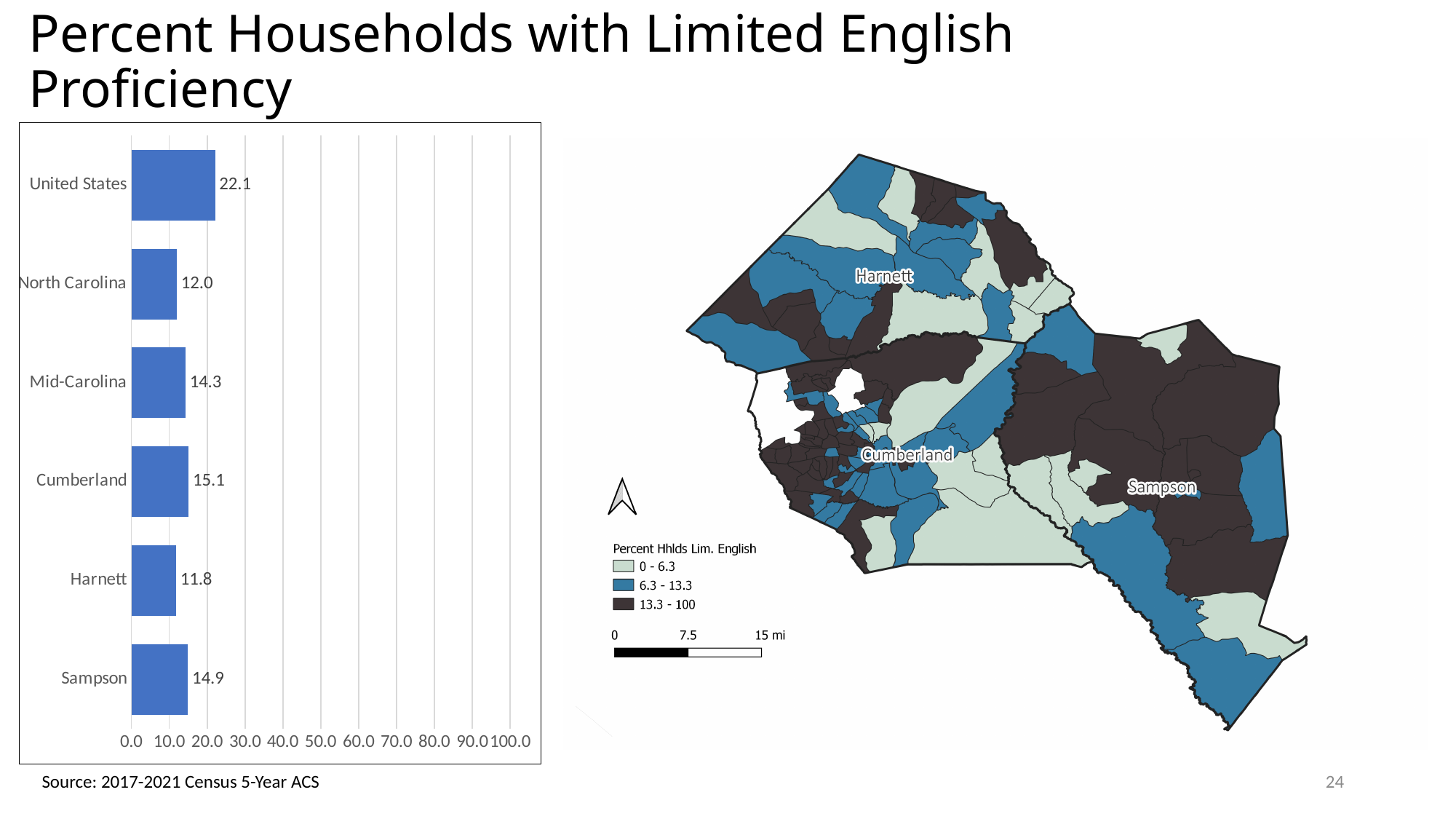
What kind of chart is shown on the left of the slide? bar chart What is the value for Cumberland in the bar chart? 15.1 Which is larger in the bar chart, Mid-Carolina or Harnett? Mid-Carolina How many categories are shown in the bar chart? 6 What is the difference between the United States and North Carolina values in the bar chart? 10.1 What is the value for United States in the bar chart? 22.1 Which category has the lowest value in the bar chart? Harnett Is the value for Cumberland in the bar chart greater or less than 20.0? less What is the highest value shown on the x axis of the bar chart? 100.0 What is the value for North Carolina in the bar chart? 12.0 Which category has the highest value in the bar chart? United States What is the value for Sampson in the bar chart? 14.9